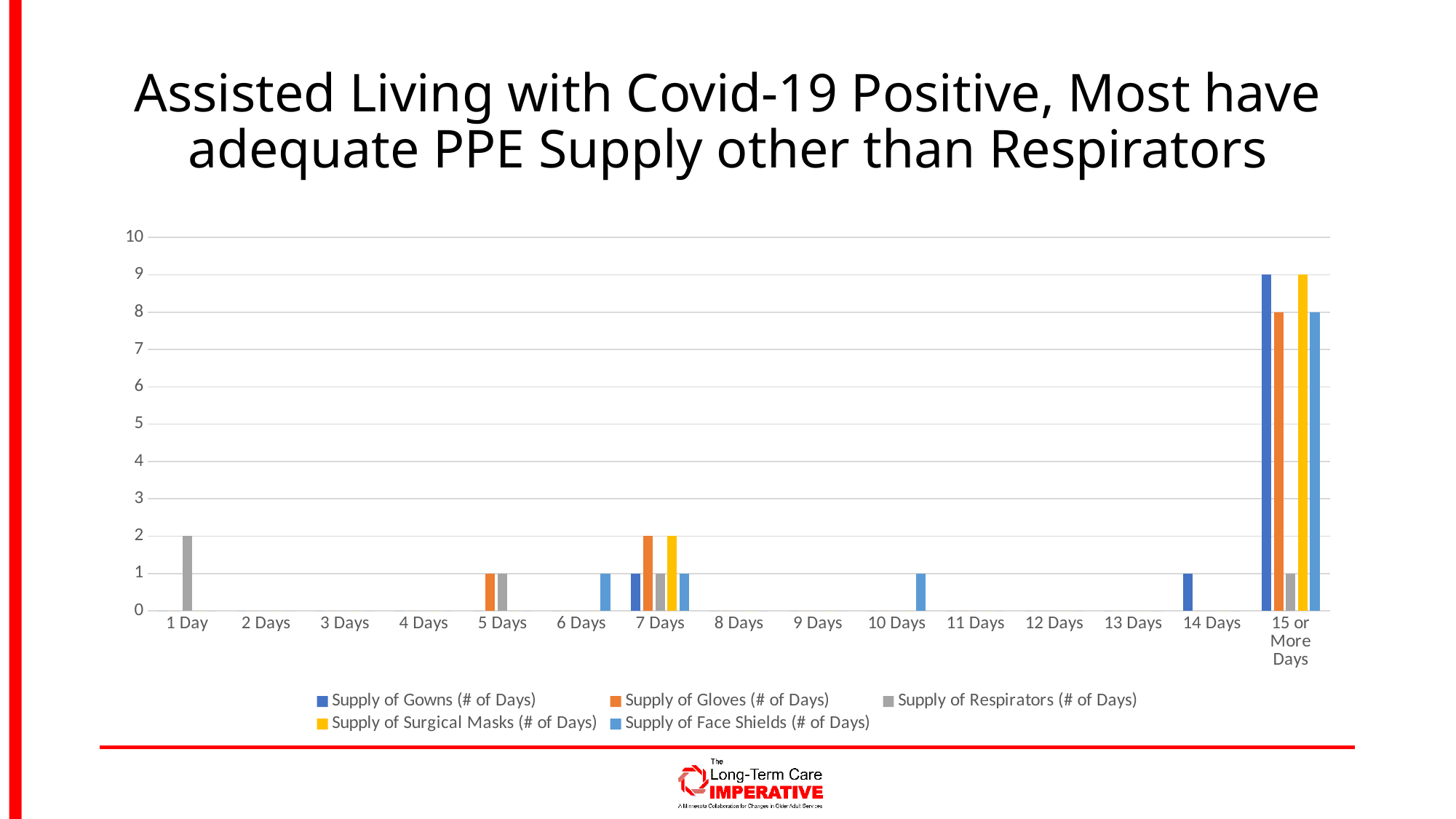
What colour represents Supply of Surgical Masks (# of Days) in the legend? Yellow What kind of chart is shown on the slide? Bar chart Is the value for Supply of Gloves (# of Days) at 15 or More Days greater or less than 5? greater How many categories are shown on the x axis? 15 Which category has the highest value for Supply of Surgical Masks (# of Days)? 15 or More Days How many series does the legend list? 5 What is the value for Supply of Face Shields (# of Days) at 15 or More Days? 8 What is the difference between Supply of Gowns (# of Days) and Supply of Respirators (# of Days) at 15 or More Days? 8 What is the value for Supply of Respirators (# of Days) at 1 Day? 2 At 15 or More Days, which is larger: Supply of Gowns (# of Days) or Supply of Respirators (# of Days)? Supply of Gowns (# of Days) What is the value for Supply of Gloves (# of Days) at 7 Days? 2 What is the value for Supply of Gowns (# of Days) at 15 or More Days? 9